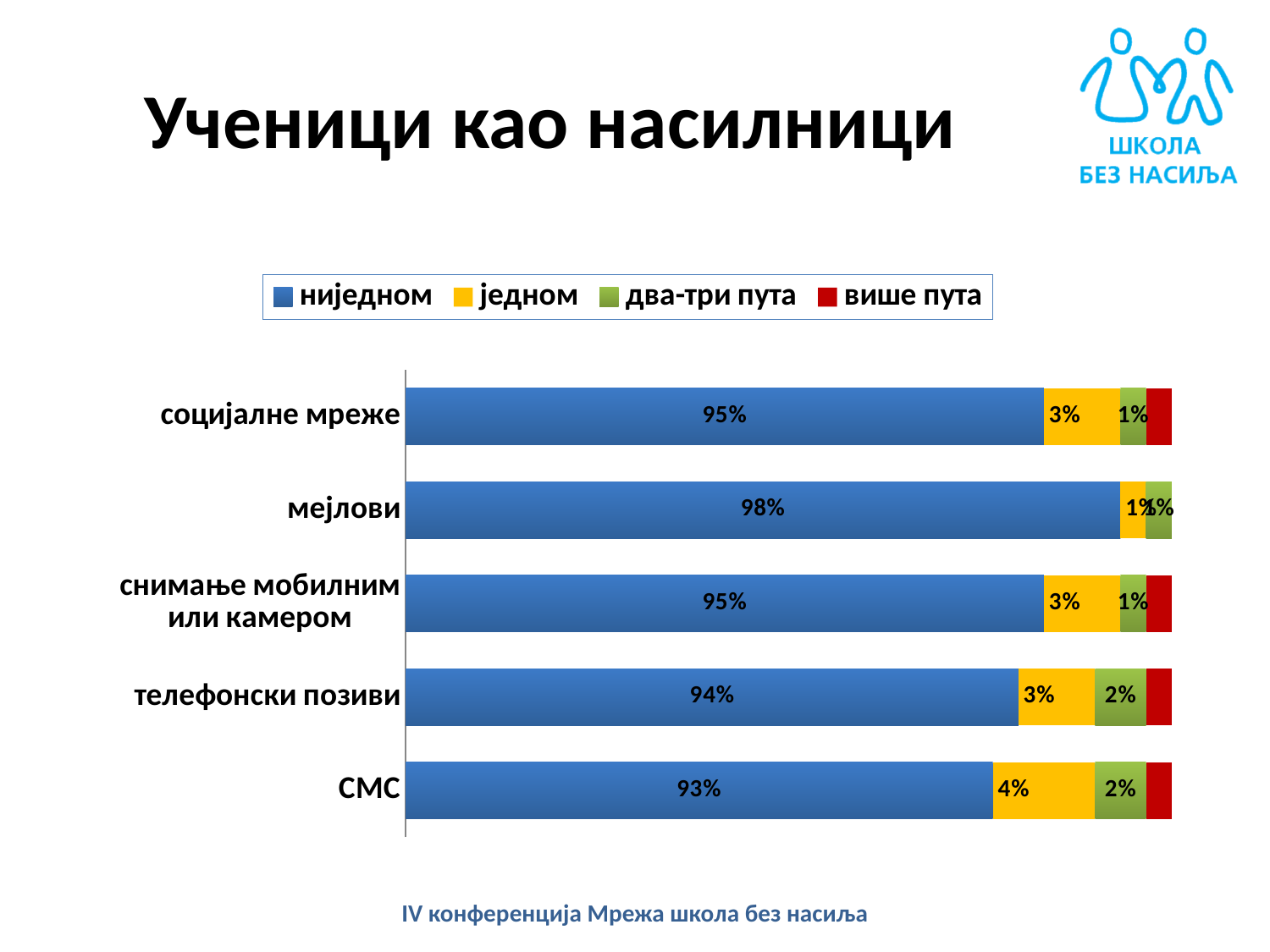
What is the value of the "ниједном" series for мејлови? 98% What is the value of the "два-три пута" series for телефонски позиви? 2% What is the difference between the "ниједном" values for мејлови and СМС? 5 percentage points How many series does the legend list? 4 What kind of chart is shown on the slide? Stacked bar chart What colour represents the "ниједном" series in the legend? Blue Which category has the highest value for the "ниједном" series? мејлови What is the value of the "једном" series for СМС? 4% What is the value of the "ниједном" series for СМС? 93% Which has a larger "ниједном" value: социјалне мреже or телефонски позиви? социјалне мреже Which category has the lowest value for the "ниједном" series? СМС How many categories are shown on the chart? 5